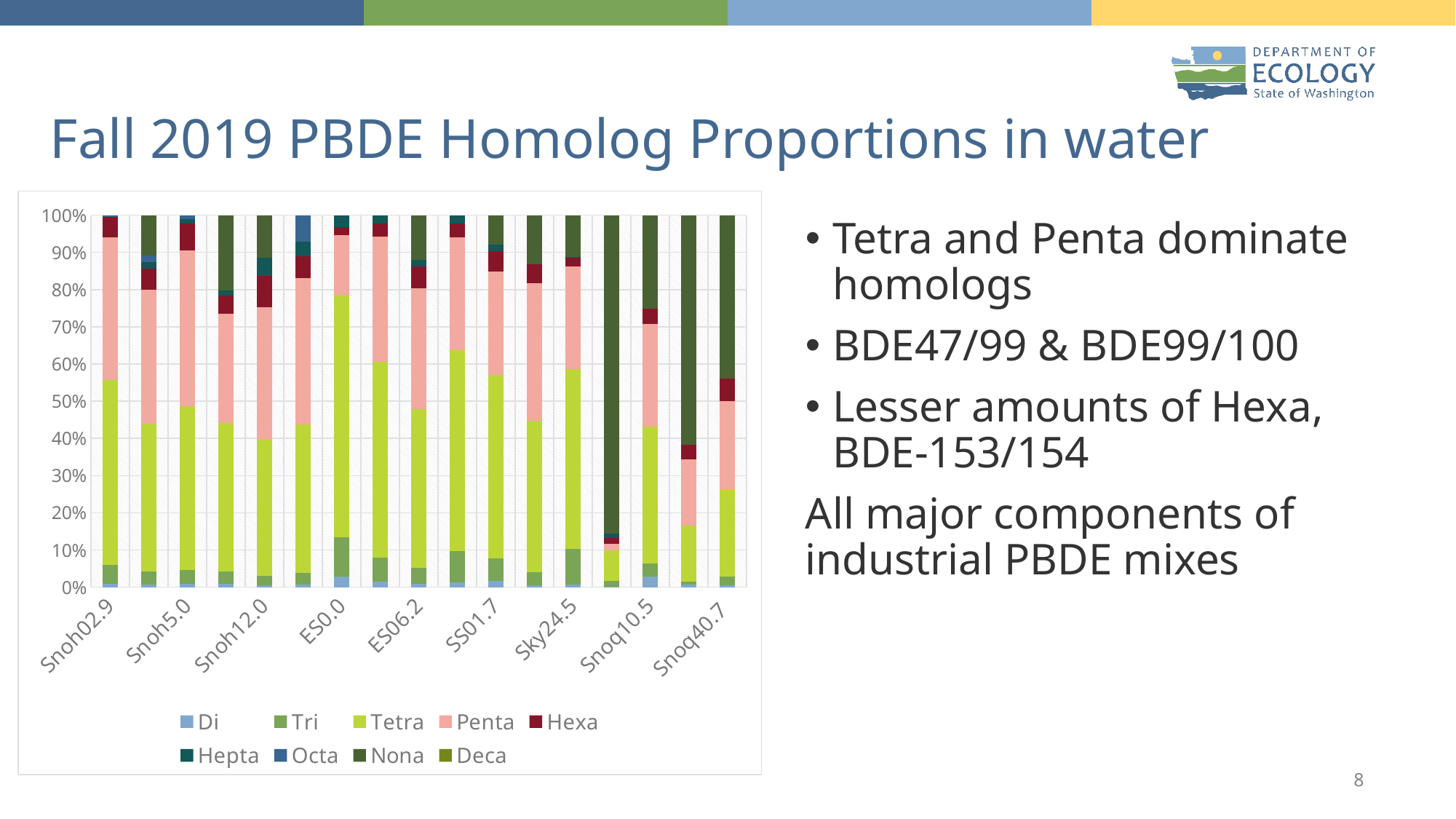
Is the Tetra share for Snoq10.5 greater or less than 20%? greater Which series is listed first in the chart legend? Di Is the Tetra share for ES0.0 greater or less than 70%? less How many series does the chart legend list? 9 What is the title of the slide containing the chart? Fall 2019 PBDE Homolog Proportions in water Among the labelled sites, which has the largest Tetra share? ES0.0 What kind of chart is shown on the slide? Stacked bar chart Among the labelled sites, which has the largest Nona share? Snoq40.7 Is the Nona share for Snoq10.5 greater or less than 50%? less Which has the larger Tetra share, ES0.0 or Snoq10.5? ES0.0